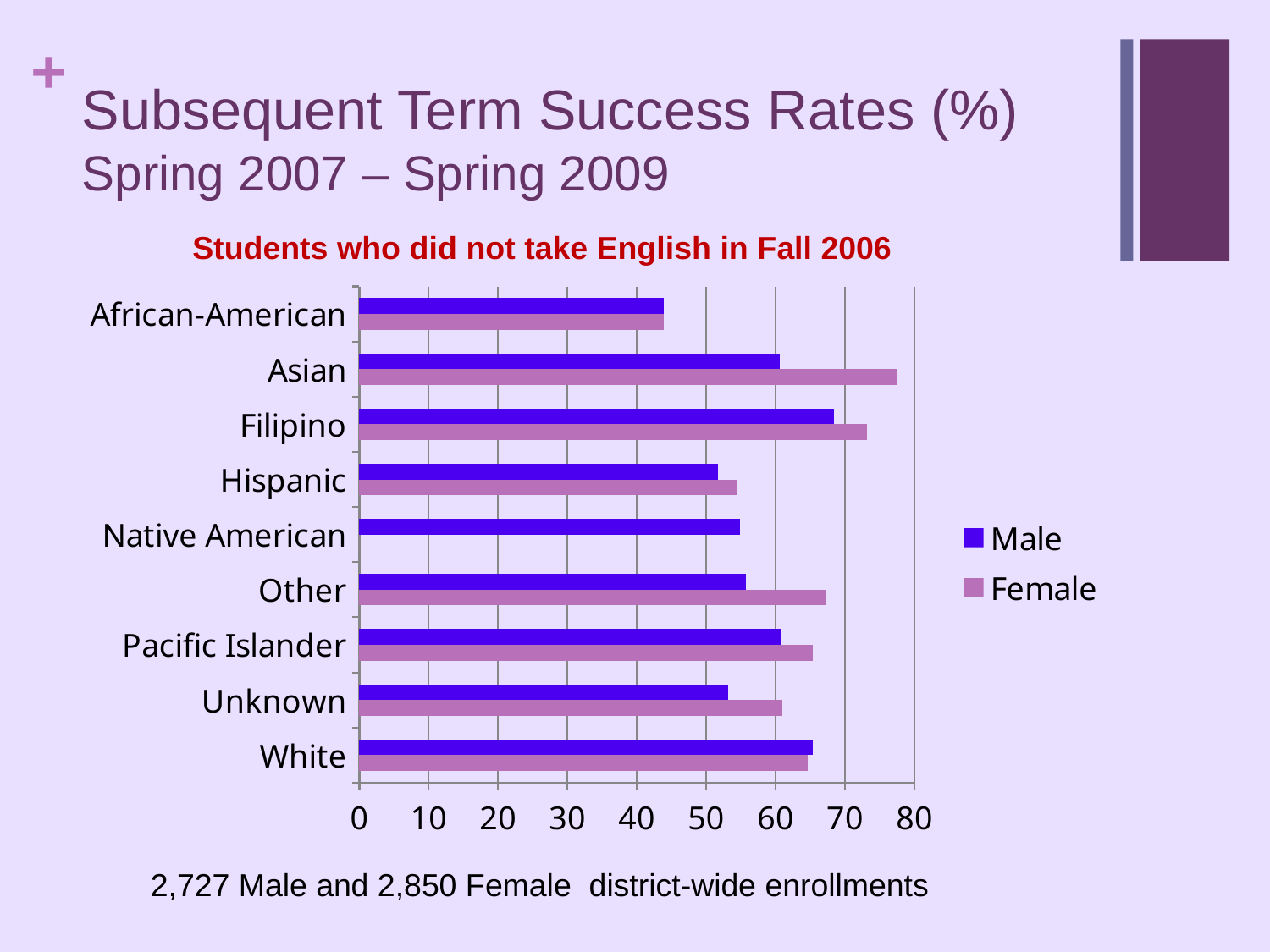
For Asian students, which is larger, the Male or the Female success rate? Female Is the Female value for Other greater or less than 60? greater Which category has the highest Female success rate? Asian What is the title of the chart? Students who did not take English in Fall 2006 Is the Female value for Asian greater or less than 70? greater How many ethnic categories are shown on the chart? 9 Which category has the lowest Male success rate? African-American Is the Male value for Unknown greater or less than 60? less Which category has the highest Male success rate? Filipino What kind of chart is shown on the slide? bar chart How many series does the legend list? 2